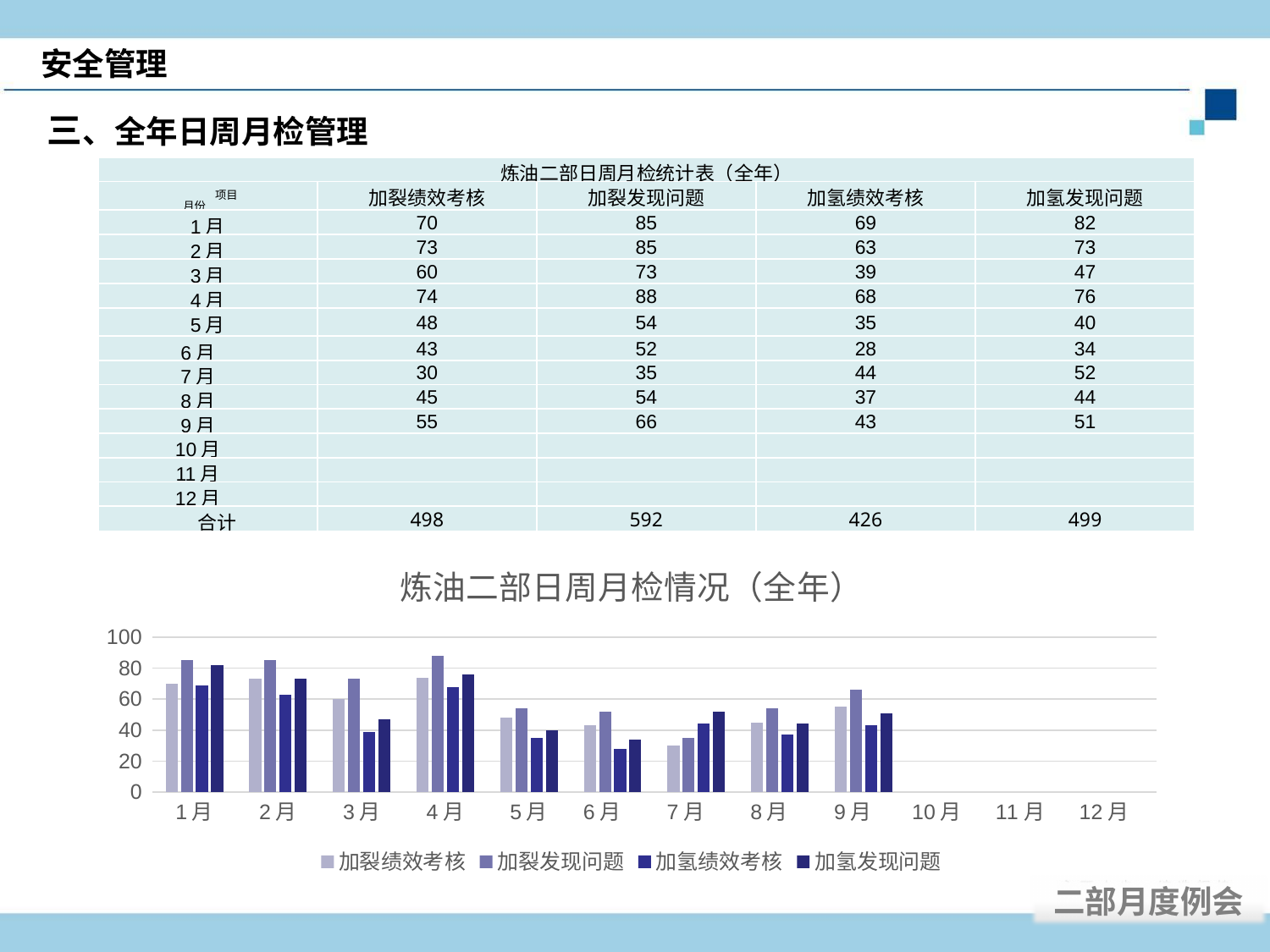
How many month categories are shown on the x axis of the chart? 12 How many series does the chart legend list? 4 In 2月, which is larger: 加裂绩效考核 or 加氢绩效考核? 加裂绩效考核 Which month has the highest value for 加裂发现问题? 4月 What is the difference between the 加裂绩效考核 values for 1月 and 7月? 40 Which month has the lowest value for 加氢绩效考核? 6月 Does the value of 加裂绩效考核 rise or fall from 4月 to 7月? fall What is the title of the chart? 炼油二部日周月检情况（全年） Is the value for 加氢绩效考核 in 6月 greater or less than 40? less What is the value of 加氢发现问题 for 9月? 51 What is the value of 加裂发现问题 for 4月? 88 What kind of chart is shown on the slide? bar chart